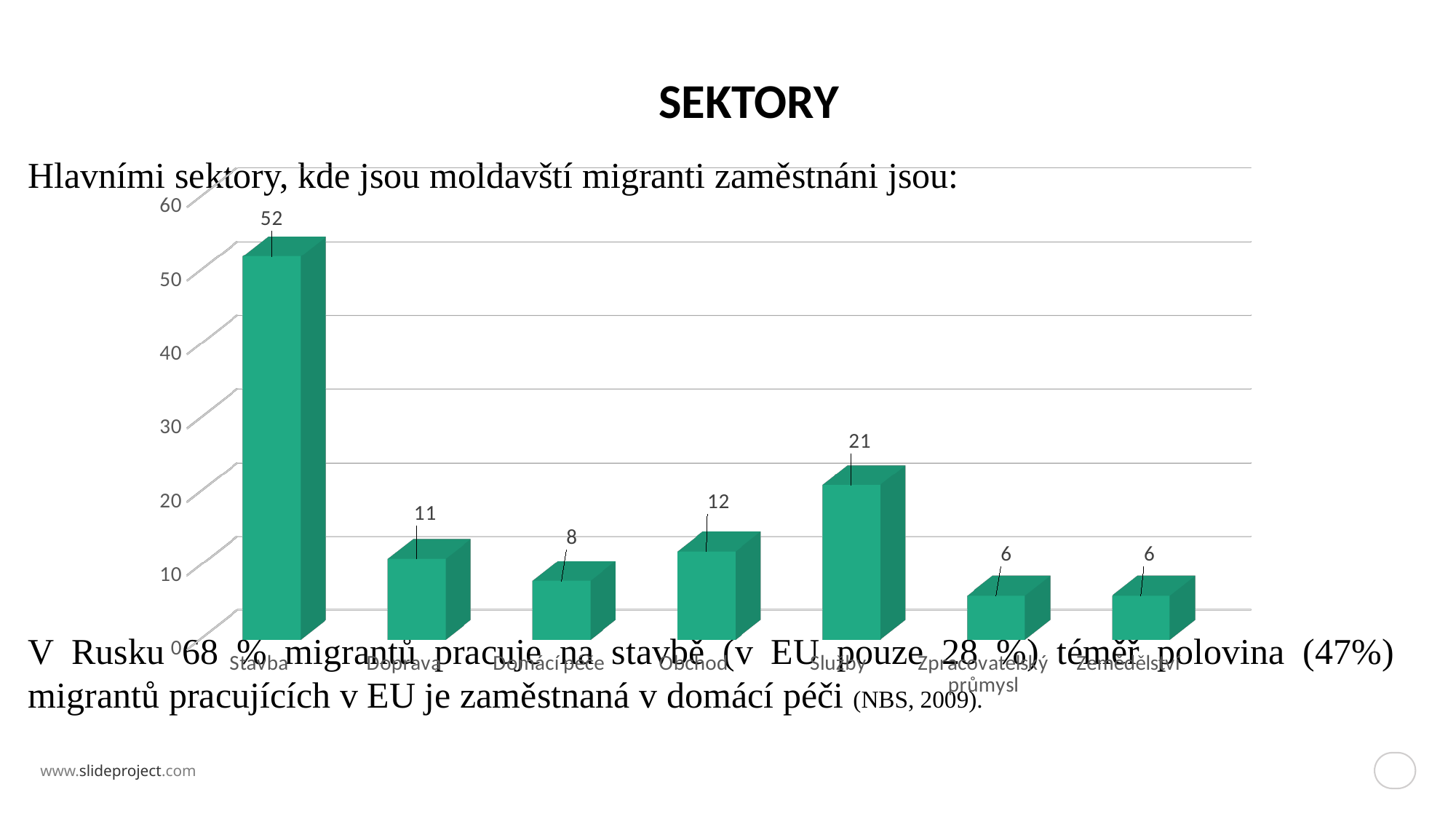
Which category has the highest value? Stavba What is the difference between the values for Obchod and Doprava? 1 What is the difference between the values for Stavba and Služby? 31 What is the value for Domácí péče? 8 What is the value for Zpracovatelský průmysl? 6 Is the value for Stavba greater or less than 50? greater What kind of chart is shown on the slide? bar chart Which is larger, the value for Služby or the value for Obchod? Služby What is the value for Služby? 21 What is the title of the slide containing the chart? SEKTORY What is the value for Stavba? 52 How many categories are shown on the x axis? 7